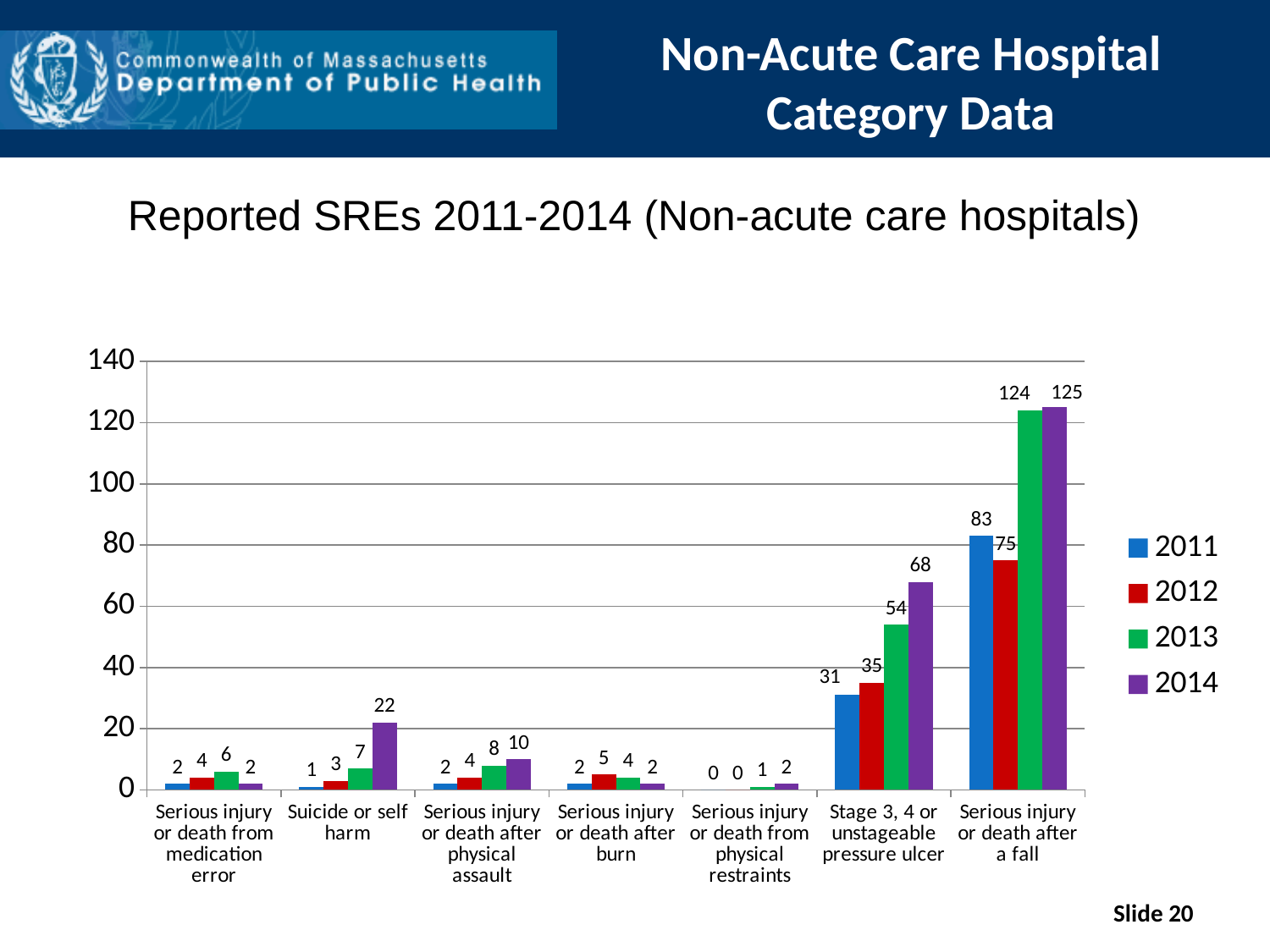
Which category has the highest 2013 value? Serious injury or death after a fall Do the values for Stage 3, 4 or unstageable pressure ulcer rise or fall from 2011 to 2014? rise What is the title of the chart? Reported SREs 2011-2014 (Non-acute care hospitals) What is the difference between the 2014 and 2011 values for Stage 3, 4 or unstageable pressure ulcer? 37 How many categories are shown on the x axis? 7 What is the 2011 value for Stage 3, 4 or unstageable pressure ulcer? 31 Which category has the lowest 2011 value? Serious injury or death from physical restraints How many series does the legend list? 4 What is the 2014 value for Suicide or self harm? 22 What is the 2014 value for Serious injury or death after a fall? 125 What kind of chart is shown? bar chart Which is larger for Serious injury or death after a fall: the 2011 value or the 2012 value? 2011